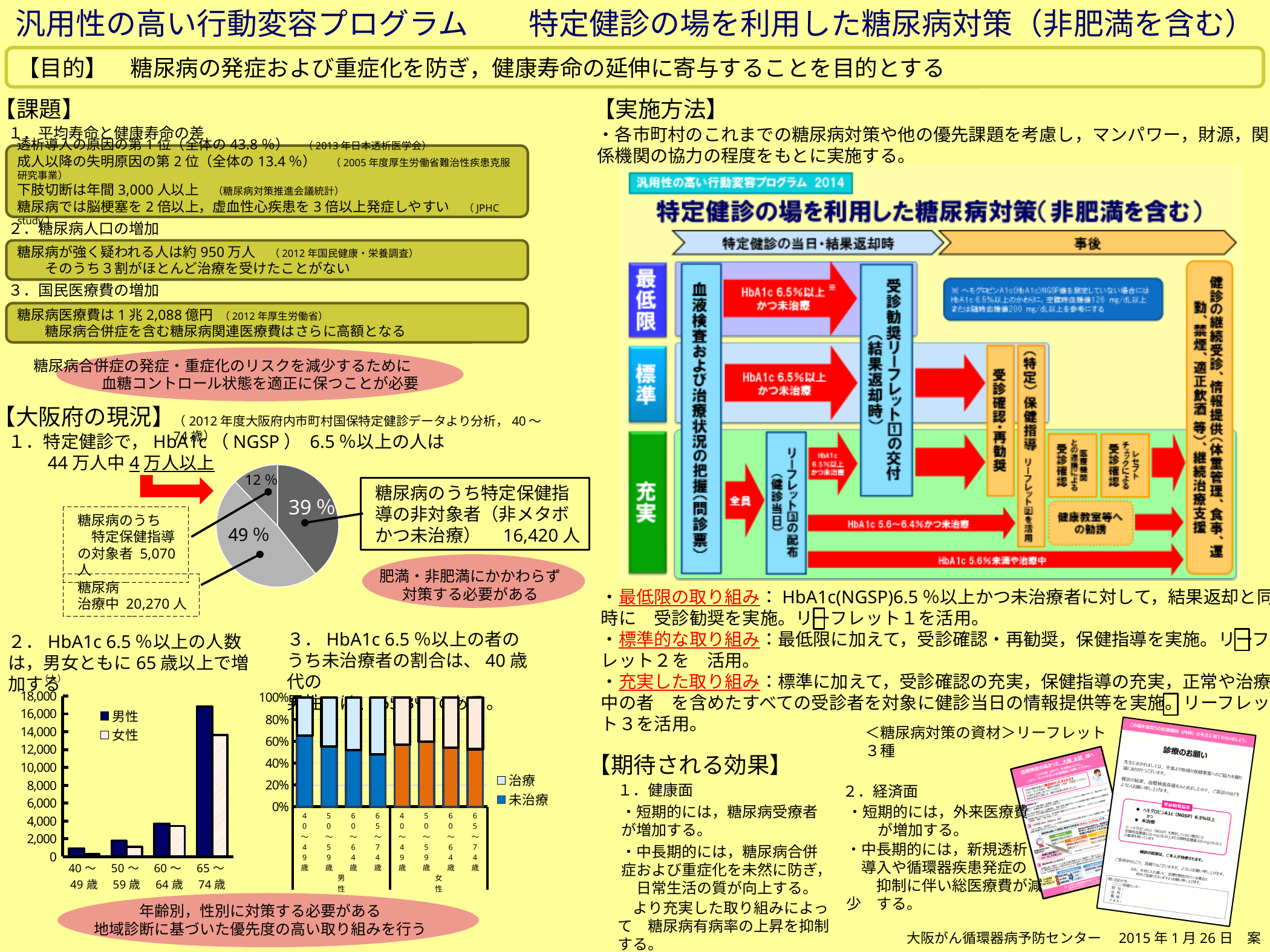
In the bottom-left bar chart of HbA1c 6.5%以上の人数, which is larger for the 40～49歳 group, 男性 or 女性? 男性 What kind of chart is the bottom-left chart showing HbA1c 6.5%以上の人数 by age group and sex? bar chart In the pie chart, what share is labelled for the slice representing 糖尿病治療中 (20,270人)? 49% In the pie chart, what share is labelled for the slice representing 特定保健指導の対象者 (5,070人)? 12% In the bottom-left bar chart of HbA1c 6.5%以上の人数, how many series does the legend list? 2 In the bottom-middle stacked bar chart of treatment status by sex and age, what are the two series listed in the legend? 治療, 未治療 In the pie chart, which slice is the largest? 糖尿病治療中 (49%) In the pie chart, how many slices are there? 3 In the bottom-left bar chart of HbA1c 6.5%以上の人数, is the value for 男性 in the 65～74歳 group greater or less than 16,000? greater In the pie chart, what share is labelled for the slice representing 特定保健指導の非対象者 (16,420人)? 39% What kind of chart is the chart showing the breakdown of people with HbA1c 6.5% or higher (12%, 39%, 49%)? pie chart In the bottom-left bar chart of HbA1c 6.5%以上の人数, which age group has the highest value for 男性? 65～74歳